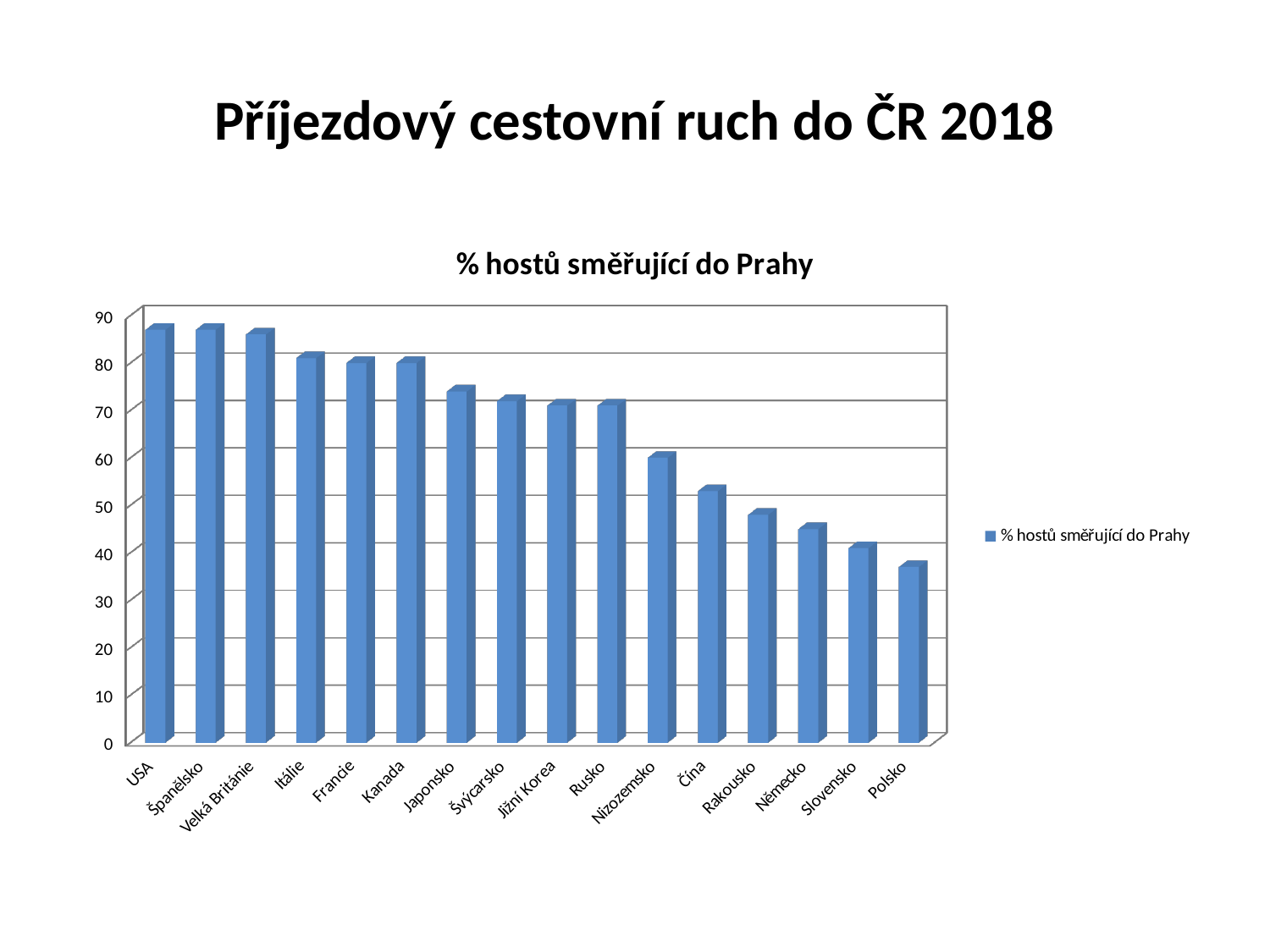
What kind of chart is shown on the slide? bar chart Is the value for Velká Británie greater or less than 80? greater Which country has the lowest value in the chart? Polsko How many series does the legend list? 1 Is the value for Čína greater or less than 50? greater Which has the larger value, Kanada or Japonsko? Kanada Which has the larger value, Nizozemsko or Slovensko? Nizozemsko Is the value for Polsko greater or less than 40? less What is the title of the chart? % hostů směřující do Prahy Do the values rise or fall from left to right along the x axis? fall How many countries are shown on the x axis of the chart? 16